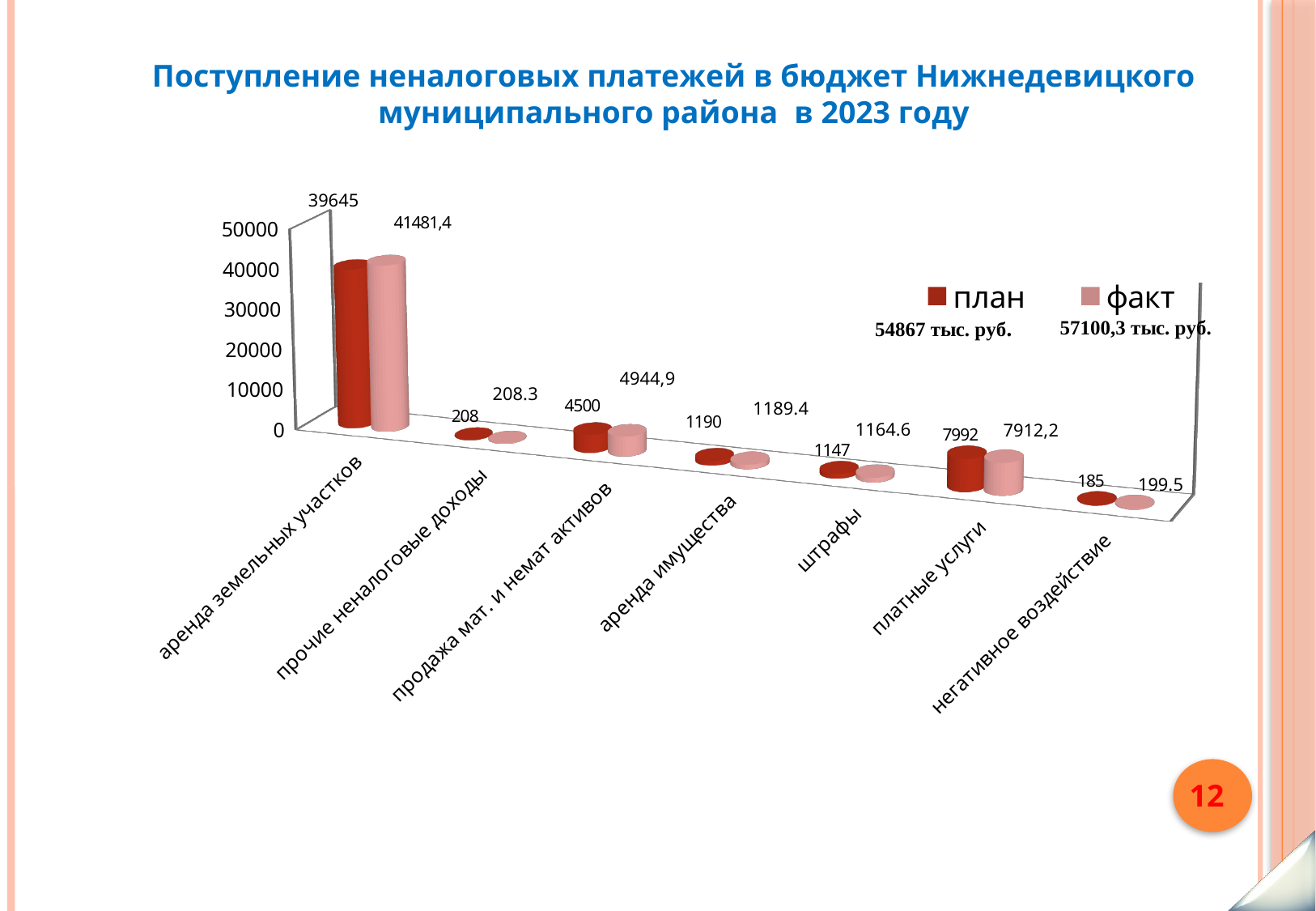
What is the факт value for негативное воздействие? 199.5 What is the difference between the факт and план values for негативное воздействие? 14.5 What total is shown under the факт legend entry? 57100,3 тыс. руб. Which category has the highest факт value? аренда земельных участков What is the план value for платные услуги? 7992 Which category has the lowest план value? негативное воздействие What is the план value for аренда земельных участков? 39645 What is the факт value for продажа мат. и немат активов? 4944,9 How many series does the legend list? 2 How many categories are shown on the x axis? 7 Which is larger for платные услуги, the план value or the факт value? план What is the difference between the факт and план values for продажа мат. и немат активов? 444,9